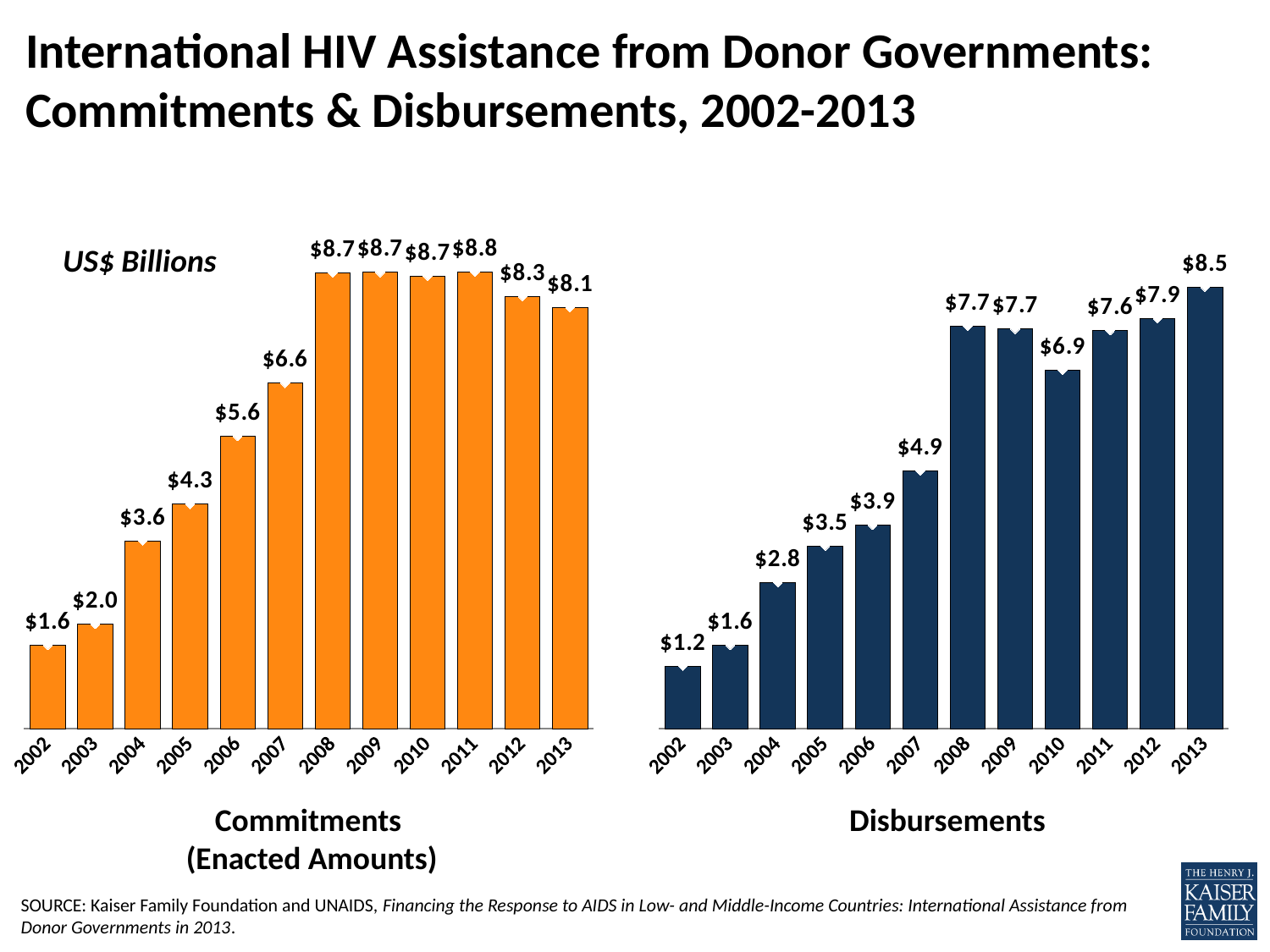
What unit is stated for the values on the slide? US$ Billions In the Commitments (Enacted Amounts) chart, what is the value for 2007? $6.6 How many years are shown in the Disbursements chart? 12 In the Disbursements chart, what is the difference between the 2013 value and the 2012 value? $0.6 In the Disbursements chart, what is the value for 2010? $6.9 In the Commitments (Enacted Amounts) chart, what is the difference between the 2006 value and the 2005 value? $1.3 Which is larger: the 2013 value in the Commitments (Enacted Amounts) chart or the 2013 value in the Disbursements chart? Disbursements What type of chart is the Commitments (Enacted Amounts) chart? Bar chart In the Commitments (Enacted Amounts) chart, which year has the highest value? 2011 In the Disbursements chart, which year has the lowest value? 2002 In the Disbursements chart, which is larger: the value for 2010 or the value for 2011? 2011 In the Commitments (Enacted Amounts) chart, do the values generally rise or fall from 2002 to 2008? Rise